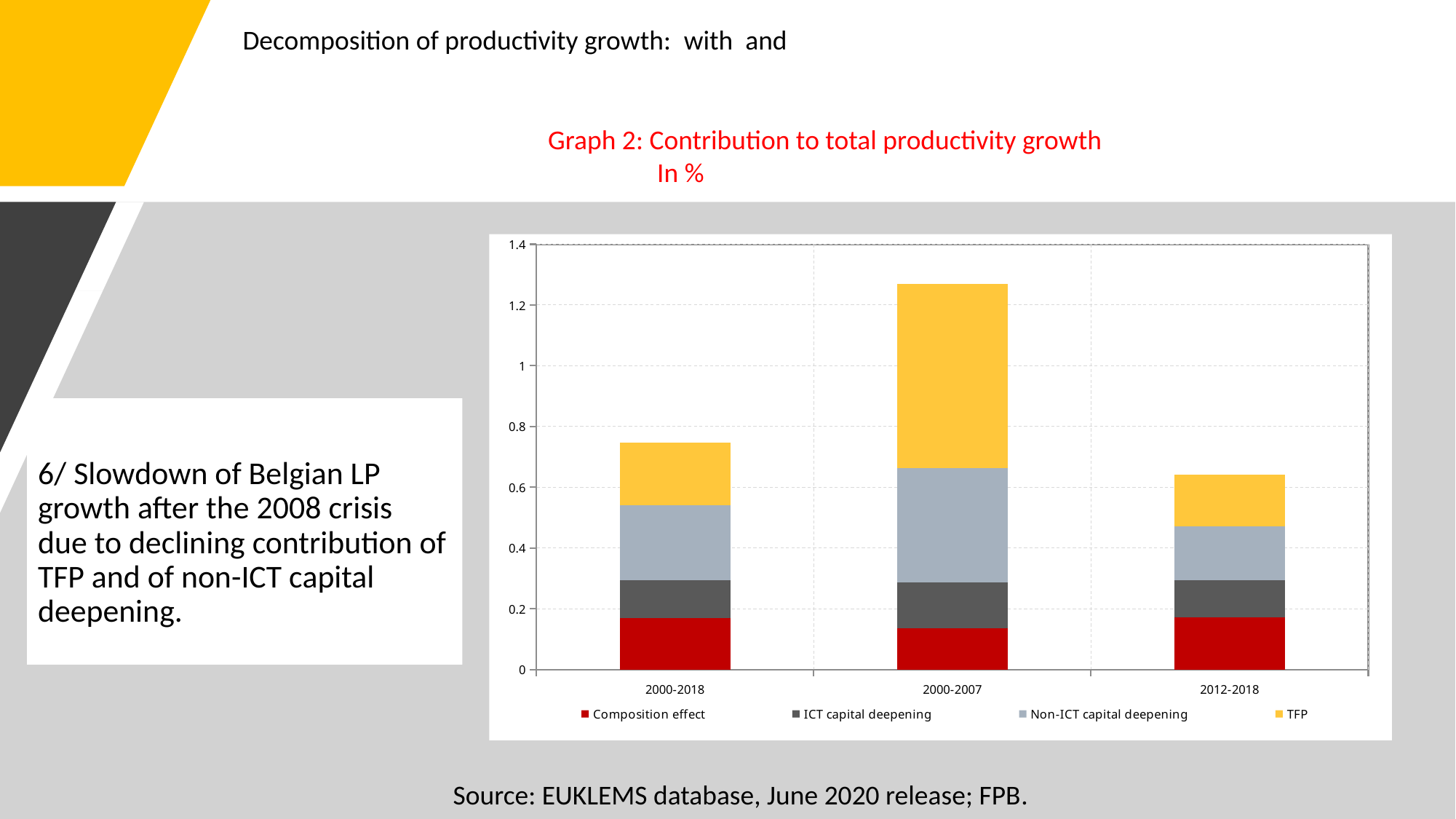
Is the total bar height for 2012-2018 greater or less than 0.8? less How many series does the chart's legend list? 4 What kind of chart is shown on the slide? Stacked bar chart Is the total bar height for 2000-2018 greater or less than 0.8? less Which period has the lowest total productivity growth in the chart? 2012-2018 Is the total for 2000-2007 larger or smaller than the total for 2012-2018? larger Which period has the largest TFP contribution? 2000-2007 What is the title of the chart? Graph 2: Contribution to total productivity growth Which period has the highest total productivity growth in the chart? 2000-2007 Is the total bar height for 2000-2007 greater or less than 1? greater How many periods (categories) are shown on the x axis of the chart? 3 Which colour represents TFP in the chart's legend? Yellow